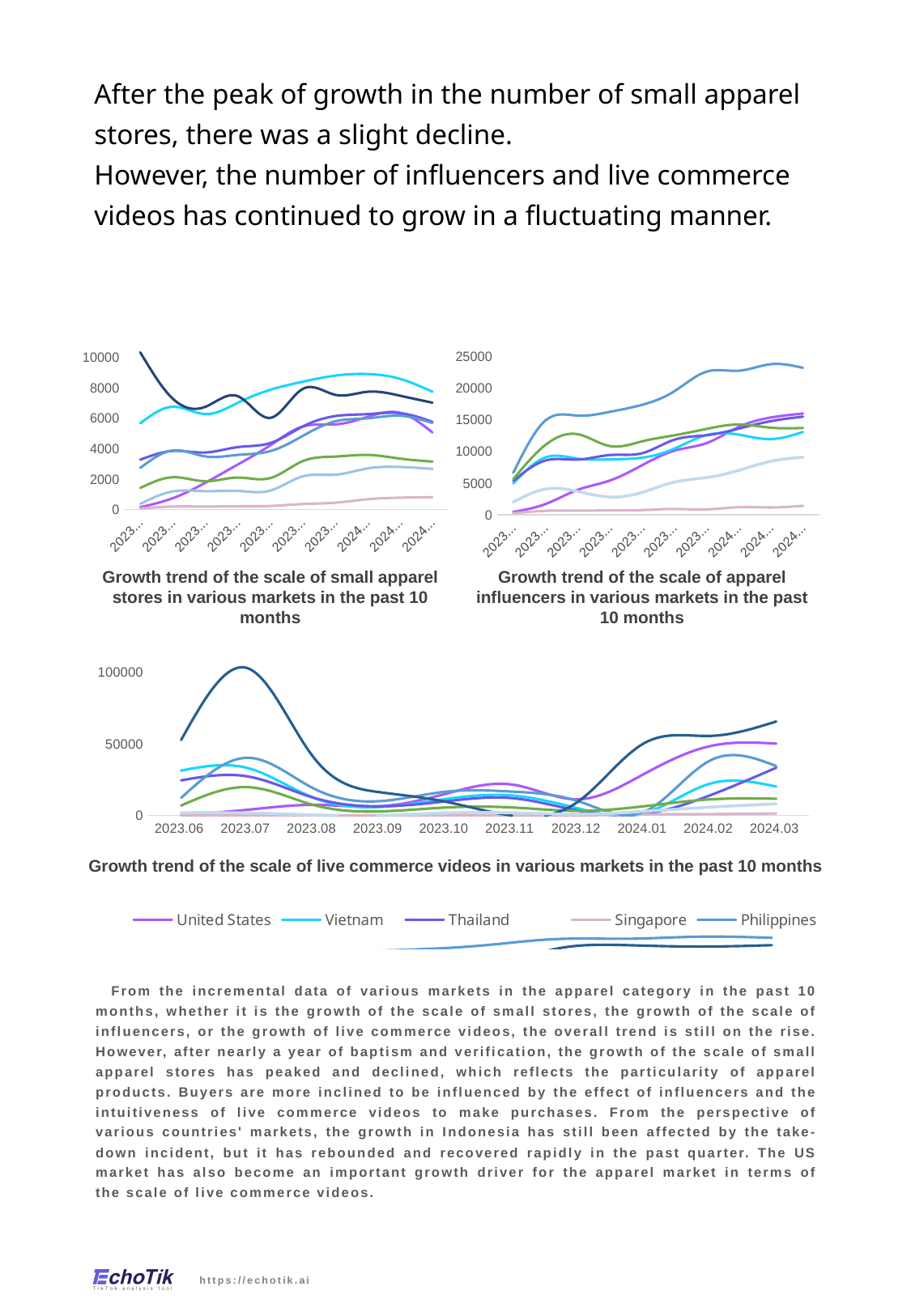
In the live commerce videos chart, how many months are shown on the x axis? 10 In the live commerce videos chart, at which month does the highest point of any line occur? 2023.07 In the chart titled 'Growth trend of the scale of small apparel stores in various markets in the past 10 months', is the value for Vietnam at the last month greater or less than 6000? greater In the live commerce videos chart, is the value for Vietnam at 2023.06 greater or less than 50000? less What kind of chart is the chart titled 'Growth trend of the scale of live commerce videos in various markets in the past 10 months'? line chart In the apparel influencers chart, which is larger at the last month, Philippines or Singapore? Philippines In the chart titled 'Growth trend of the scale of apparel influencers in various markets in the past 10 months', is the value for Philippines at the last month greater or less than 20000? greater Which market is listed first in the legend? United States In the apparel influencers chart, does the Philippines line overall rise or fall across the 10 months? rise In the live commerce videos chart, which month is the first on the x axis? 2023.06 In the live commerce videos chart, which is larger at 2023.06, Vietnam or Singapore? Vietnam